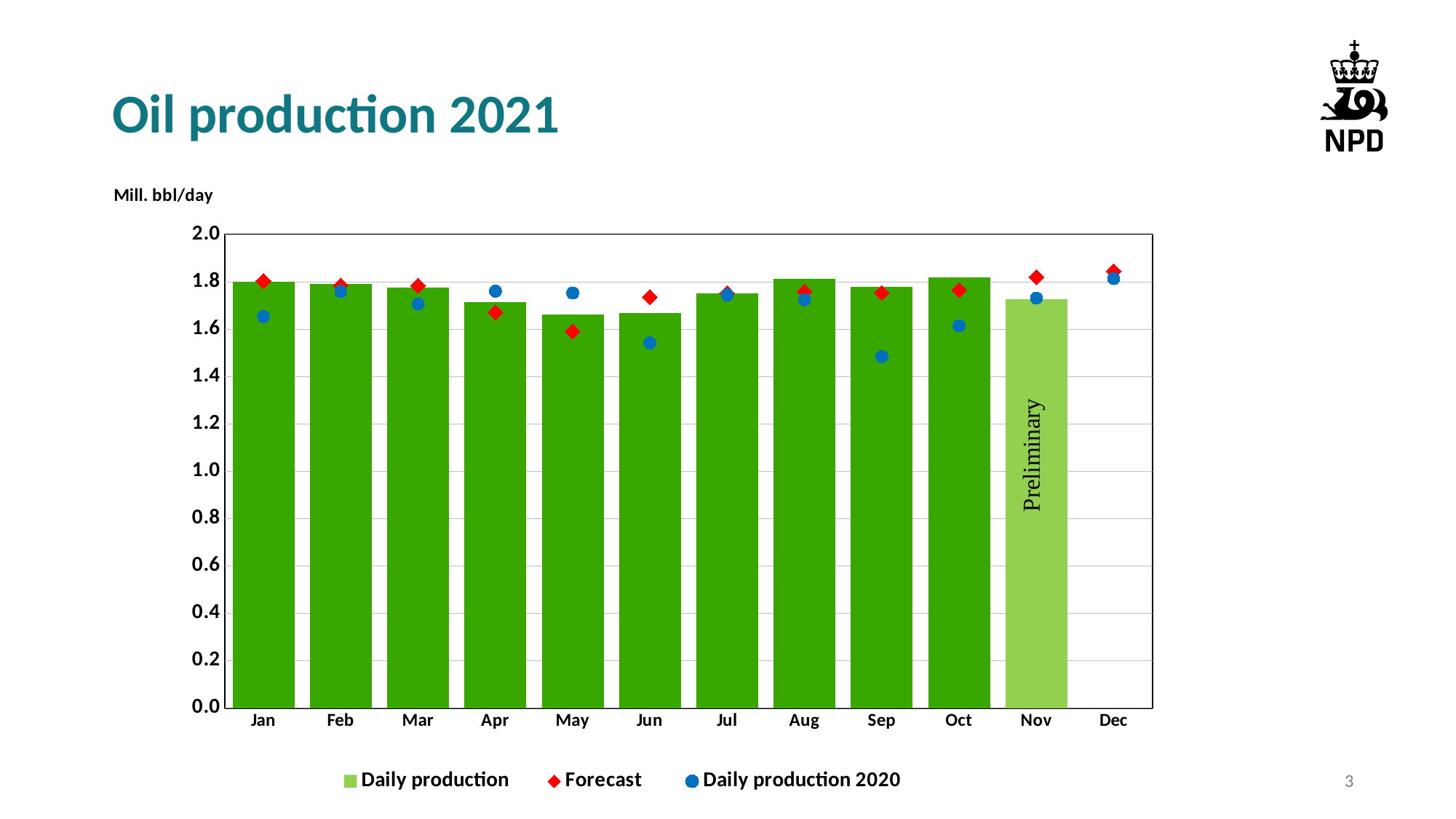
Is the Daily production value for Jan greater or less than 1.6? greater Which is larger, the Daily production bar for Jan or for May? Jan What kind of chart is used to show daily production? Bar chart Is the Forecast value for Dec greater or less than 1.8? greater What is the title of the chart? Oil production 2021 How many series does the legend list? 3 How many months are shown on the x axis? 12 Is the Daily production 2020 value for Sep greater or less than 1.6? less In Sep, which is larger, the Daily production bar or the Daily production 2020 marker? Daily production bar Which month's bar is labelled "Preliminary"? Nov